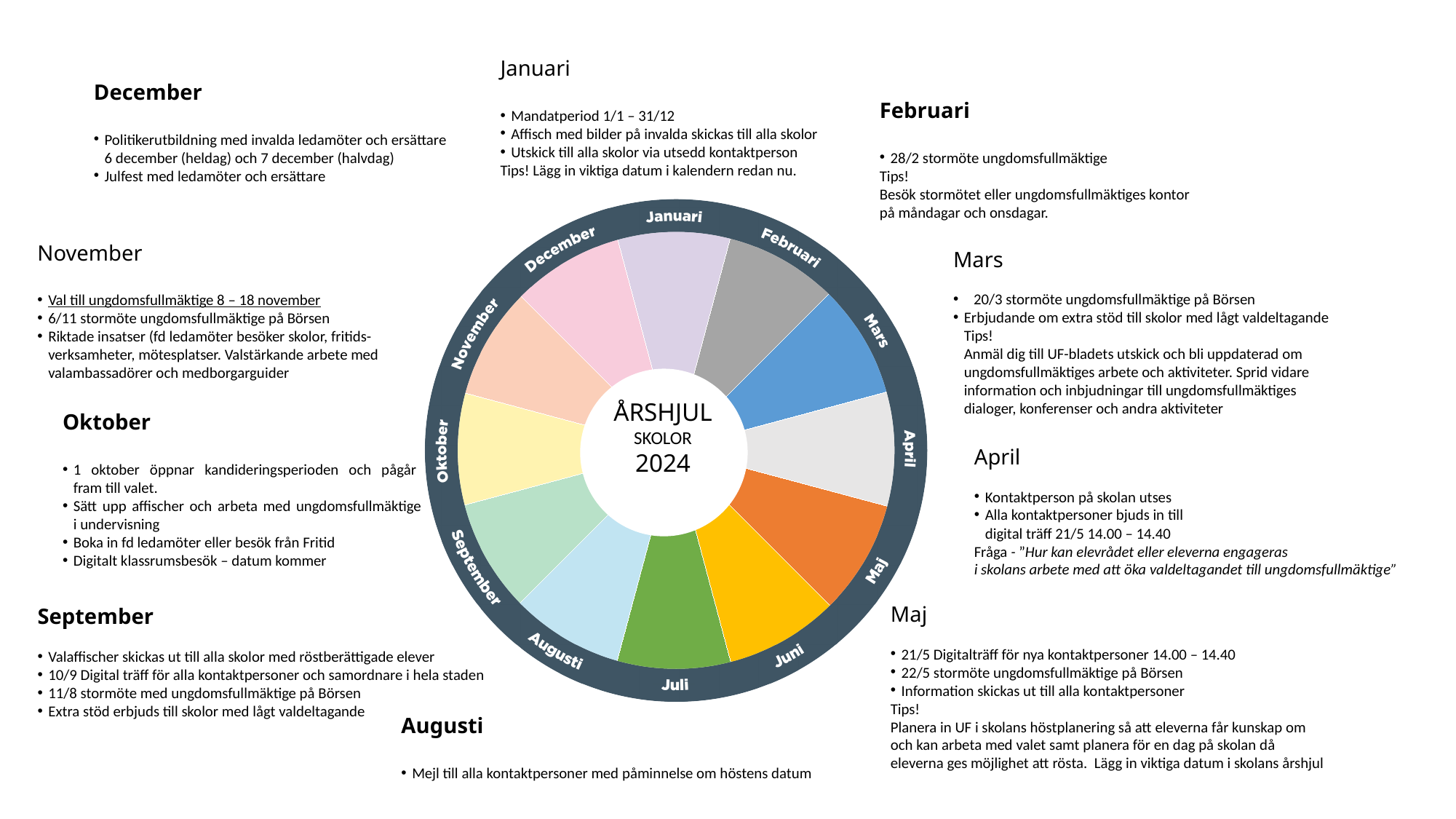
What text is written in the centre of the year wheel chart? ÅRSHJUL SKOLOR 2024 How many segments does the year wheel chart in the centre of the slide have? 12 What year is shown in the centre of the year wheel chart? 2024 What kind of chart is the year wheel in the centre of the slide? doughnut (pie) chart Which month label sits at the bottom of the year wheel chart? Juli Which month label sits at the top of the year wheel chart? Januari